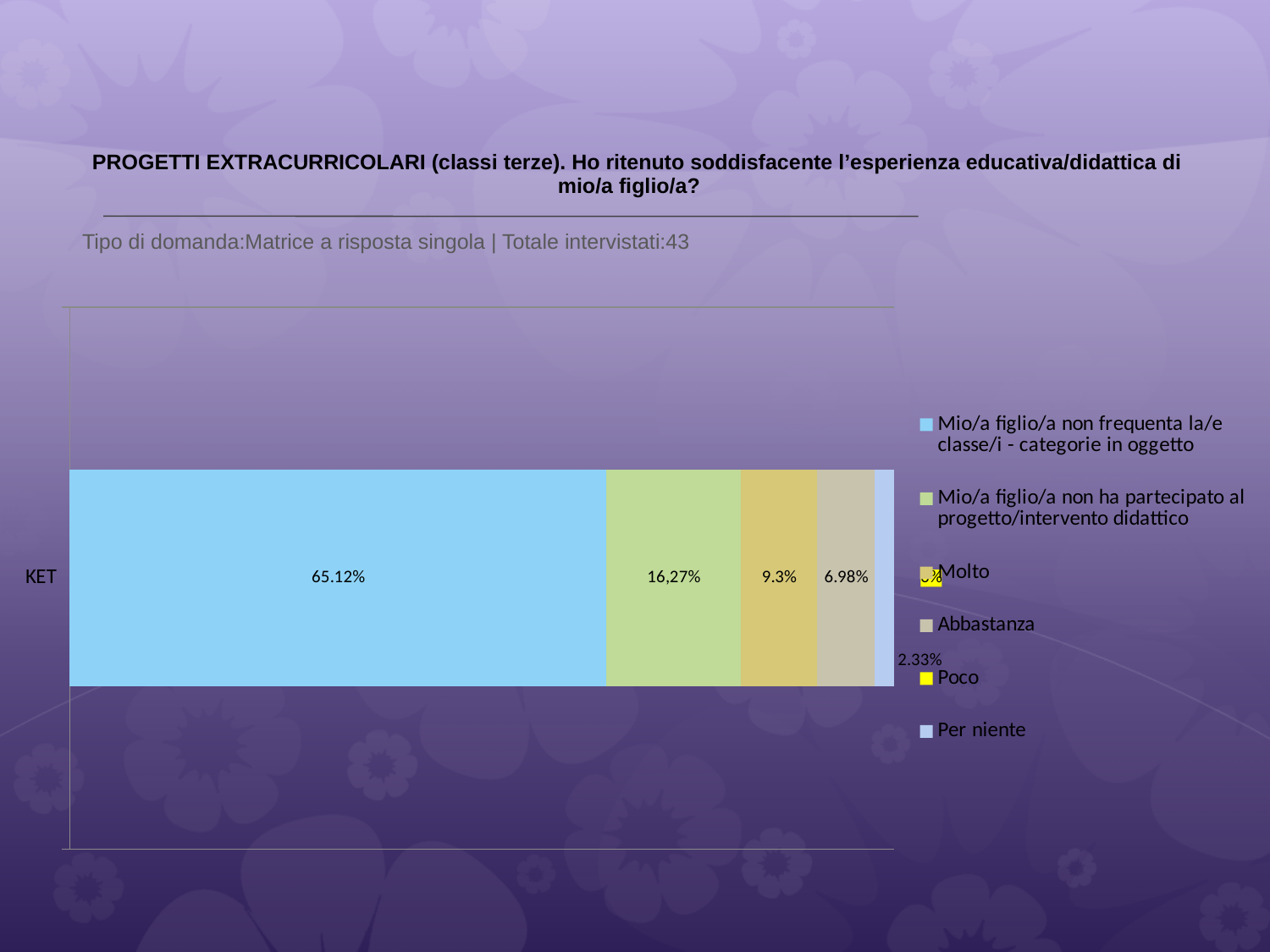
How many categories are plotted on the chart's category axis? 1 Which response option has the largest share of the KET bar? Mio/a figlio/a non frequenta la/e classe/i - categorie in oggetto What is the label of the single category on the chart's axis? KET What is the difference between the "Molto" share and the "Abbastanza" share? 2.32% What is the difference between the "Mio/a figlio/a non frequenta la/e classe/i" share and the "Mio/a figlio/a non ha partecipato al progetto/intervento didattico" share? 48.85% What percentage of respondents answered "Molto" for KET? 9.3% What percentage of respondents answered "Mio/a figlio/a non ha partecipato al progetto/intervento didattico" for KET? 16,27% What percentage of respondents answered "Mio/a figlio/a non frequenta la/e classe/i - categorie in oggetto" for KET? 65.12% How many series does the legend list? 6 What kind of chart is shown on the slide? Stacked bar chart Which is larger for KET: the share for "Molto" or the share for "Abbastanza"? Molto What percentage of respondents answered "Abbastanza" for KET? 6.98%